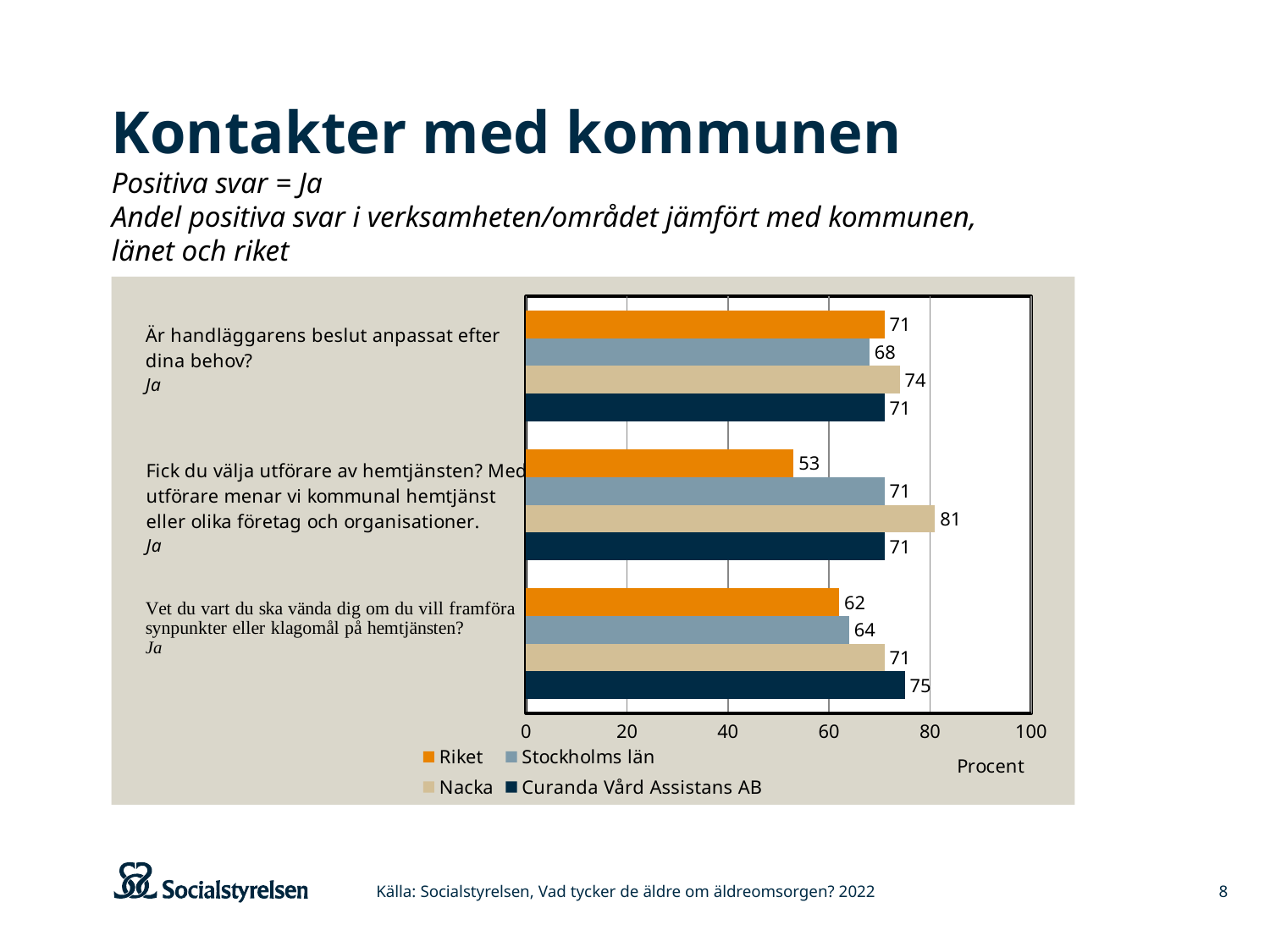
What kind of chart is shown on the slide? Bar chart What is the value for Stockholms län on the question "Är handläggarens beslut anpassat efter dina behov?"? 68 What is the difference between Nacka and Riket on the question "Fick du välja utförare av hemtjänsten?"? 28 Which series has the lowest value on the question "Fick du välja utförare av hemtjänsten?"? Riket Is the value for Riket on the question "Fick du välja utförare av hemtjänsten?" greater or less than 60? less What is the value for Curanda Vård Assistans AB on the question "Vet du vart du ska vända dig om du vill framföra synpunkter eller klagomål på hemtjänsten?"? 75 How many question categories are shown on the chart? 3 What is the value for Nacka on the question "Fick du välja utförare av hemtjänsten?"? 81 How many series does the legend list? 4 What is the value for Riket on the question "Är handläggarens beslut anpassat efter dina behov?"? 71 Which series has the highest value on the question "Vet du vart du ska vända dig om du vill framföra synpunkter eller klagomål på hemtjänsten?"? Curanda Vård Assistans AB Which is larger on the question "Vet du vart du ska vända dig om du vill framföra synpunkter eller klagomål på hemtjänsten?": Riket or Stockholms län? Stockholms län